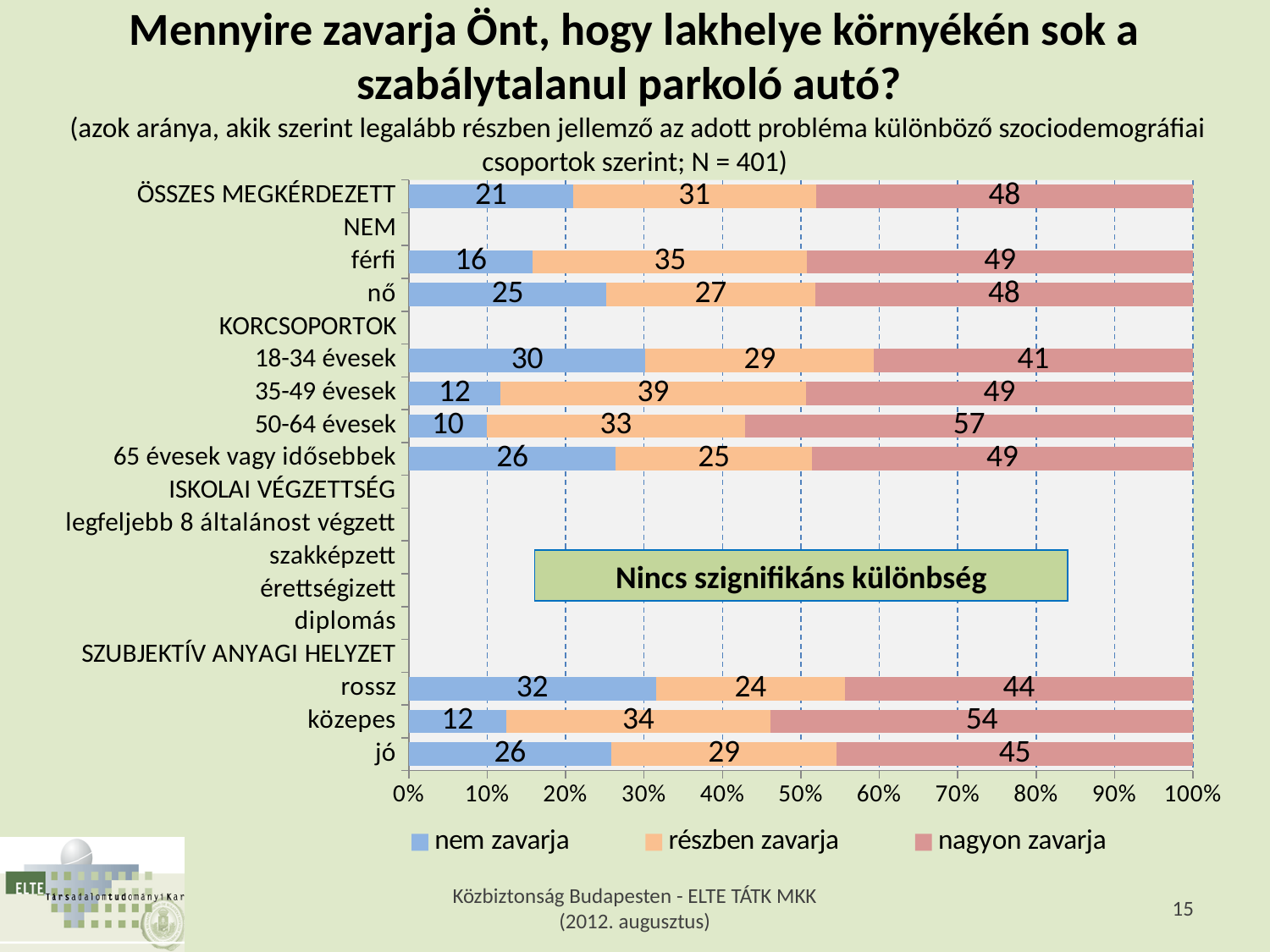
How many series does the legend list? 3 Which has the larger "nem zavarja" value: "18-34 évesek" or "65 évesek vagy idősebbek"? 18-34 évesek What does the green box placed over the "ISKOLAI VÉGZETTSÉG" rows say? Nincs szignifikáns különbség What is the value of "nagyon zavarja" for the "50-64 évesek" group? 57 What is the total of the three segments for "ÖSSZES MEGKÉRDEZETT"? 100 What is the difference between the "nagyon zavarja" values for "közepes" and "rossz"? 10 Which group has the lowest "nem zavarja" value? 50-64 évesek What is the value of "nem zavarja" for the "férfi" group? 16 What kind of chart is shown on the slide? Stacked bar chart What is the value of "részben zavarja" for the "35-49 évesek" group? 39 Which group has the highest "nagyon zavarja" value? 50-64 évesek What is the value of "nem zavarja" for the "rossz" group? 32